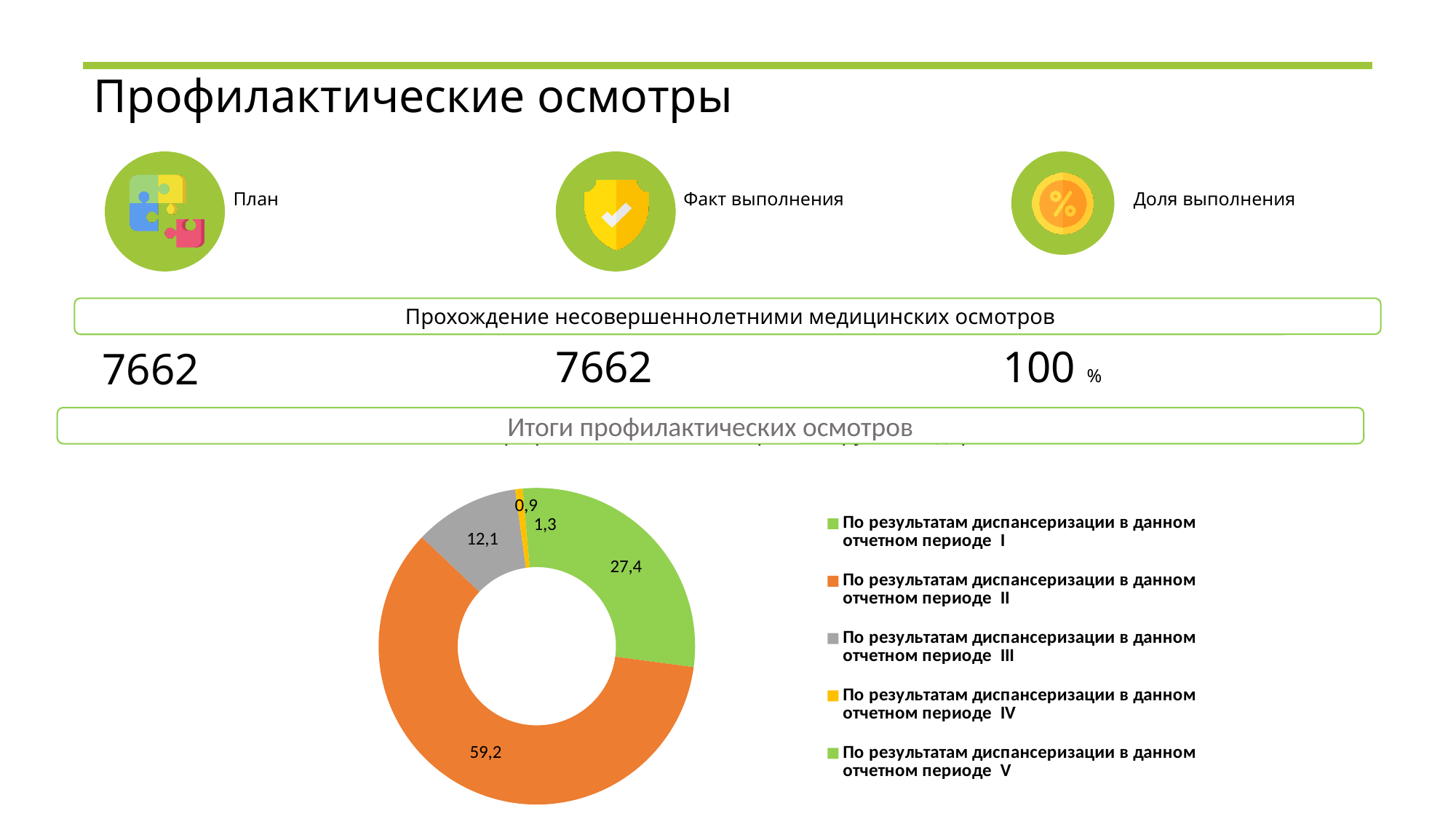
Which category has the largest slice in the doughnut chart? По результатам диспансеризации в данном отчетном периоде II What is the difference between the values for period II and period I in the doughnut chart? 31,8 How many slices are labelled with values in the doughnut chart? 5 What is the difference between the values for period I and period III in the doughnut chart? 15,3 How many entries does the legend of the doughnut chart list? 5 What is the value for "По результатам диспансеризации в данном отчетном периоде II" in the doughnut chart? 59,2 What is the value for "По результатам диспансеризации в данном отчетном периоде III" in the doughnut chart? 12,1 What kind of chart is shown on the slide under "Итоги профилактических осмотров"? Doughnut (pie) chart What colour is the slice for "По результатам диспансеризации в данном отчетном периоде II" in the doughnut chart? Orange Which is larger in the doughnut chart: the value for period I or the value for period III? Period I What is the value for "По результатам диспансеризации в данном отчетном периоде I" in the doughnut chart? 27,4 What is the heading shown directly above the doughnut chart? Итоги профилактических осмотров